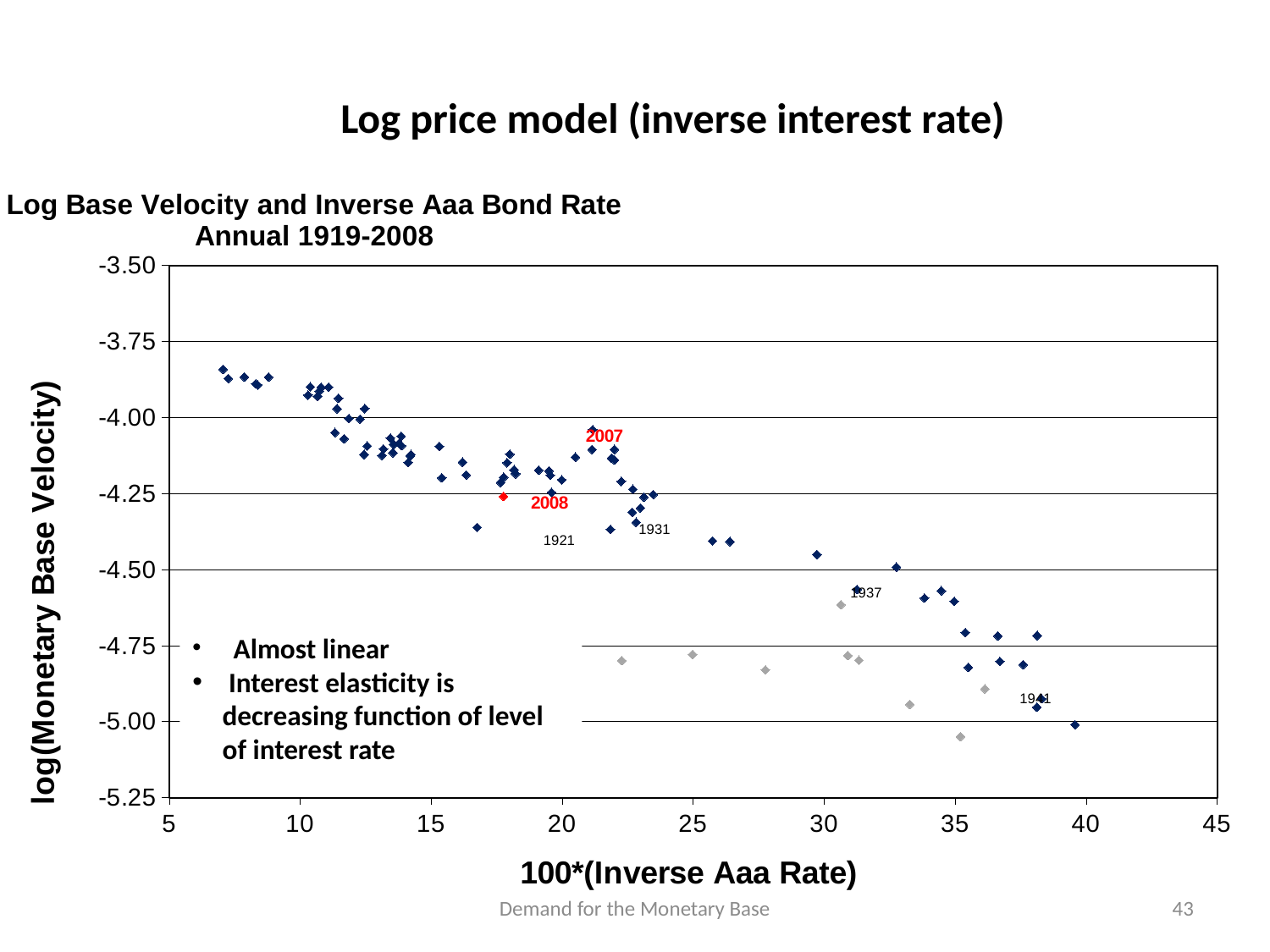
Is the log(Monetary Base Velocity) value for the point labelled 2008 greater or less than -4.00? less What kind of chart is shown on the slide? scatter chart Among the points labelled with years, which has the lowest log(Monetary Base Velocity)? 1941 As 100*(Inverse Aaa Rate) increases along the x axis, does log(Monetary Base Velocity) generally rise or fall? fall Is the log(Monetary Base Velocity) value for the point labelled 1937 greater or less than -4.50? less Is the 100*(Inverse Aaa Rate) value for the point labelled 2007 greater or less than 20? greater Which of the points labelled 2007 and 2008 has the higher log(Monetary Base Velocity)? 2007 How many points on the chart are labelled with a year? 6 What is the label of the x axis? 100*(Inverse Aaa Rate) What is the title of the chart? Log Base Velocity and Inverse Aaa Bond Rate Annual 1919-2008